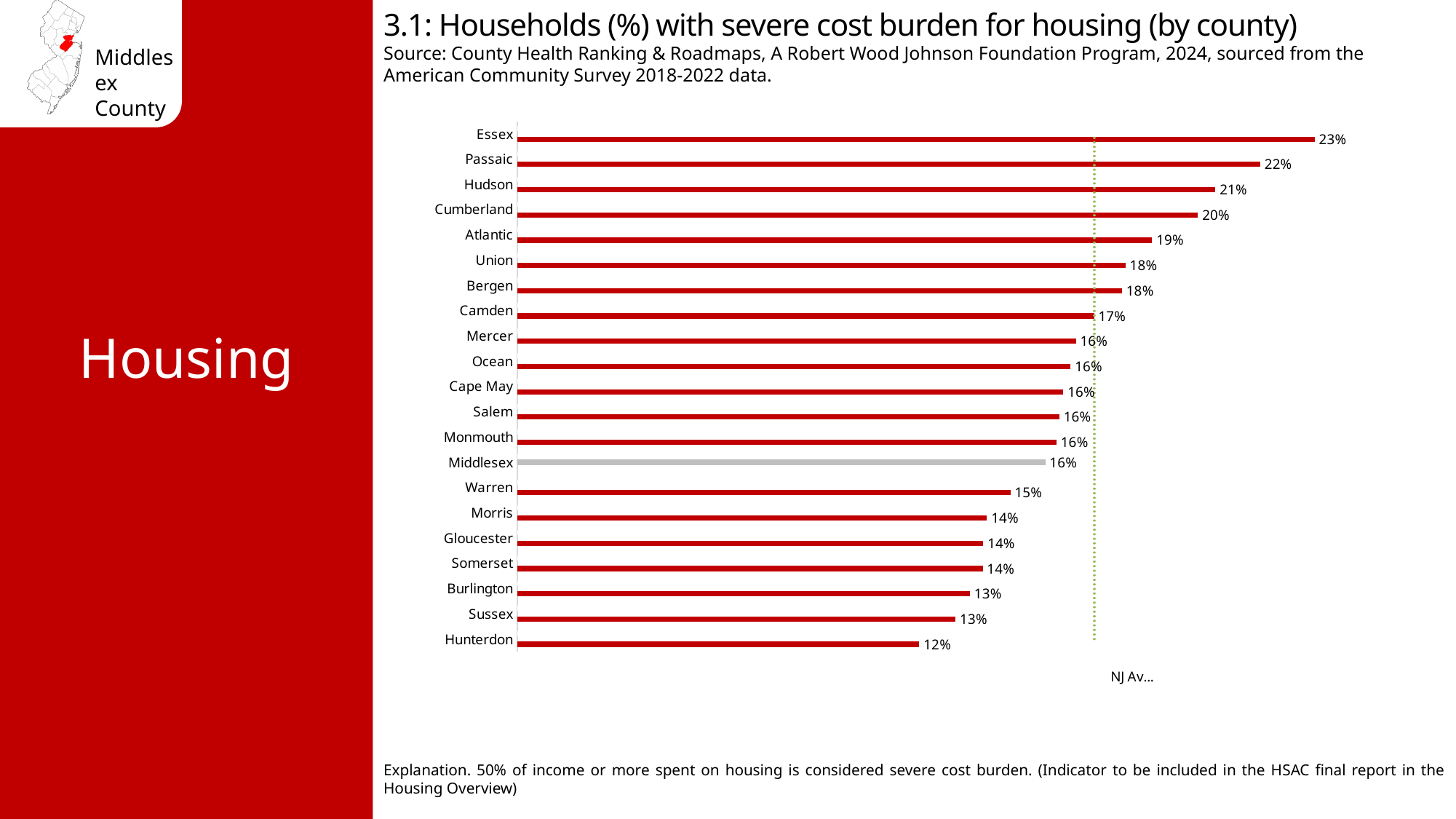
Which county's bar is drawn in grey instead of red? Middlesex Which has a higher value, Hudson or Atlantic? Hudson What is the difference between the values for Essex and Hunterdon? 11% How many counties are plotted in the chart? 21 What percentage of households in Essex County have a severe housing cost burden? 23% What percentage is shown for Hunterdon County? 12% Which county has the highest percentage of households with severe housing cost burden? Essex What is the difference between the values for Passaic and Middlesex? 6% What kind of chart is shown on the slide? Bar chart What is the value shown for Middlesex County? 16% Which county has the lowest percentage of households with severe housing cost burden? Hunterdon Which has a higher value, Warren or Sussex? Warren